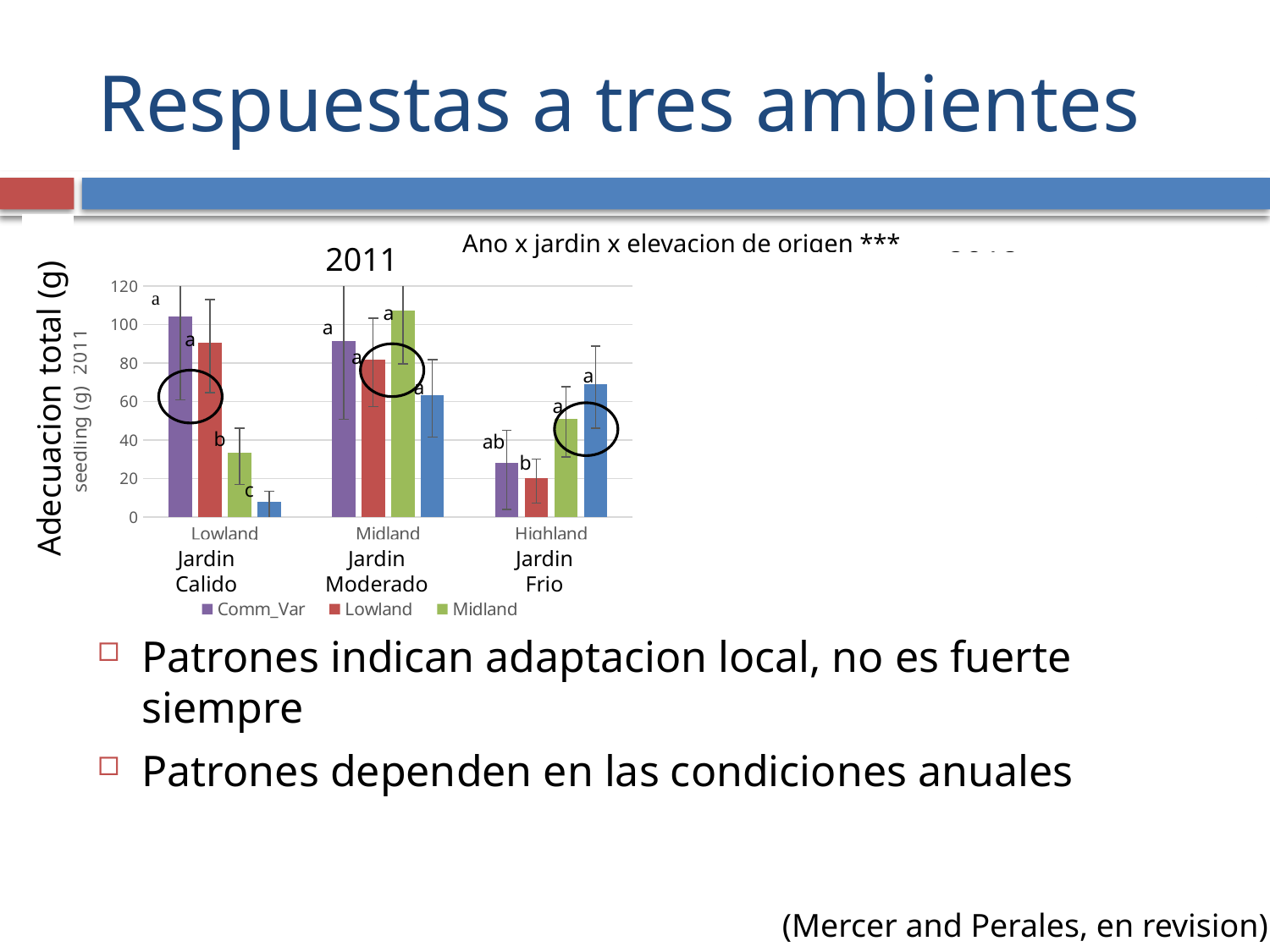
Which series has the highest bar in the Midland category? Midland What is the highest tick value shown on the y axis of the chart? 120 Is the value for the Midland series in the Midland category greater or less than 80? greater Is the value for the Midland series in the Lowland category greater or less than 40? less Is the value for Comm_Var in the Lowland category greater or less than 80? greater What is the title shown above the chart? 2011 How many bars are plotted in each category group of the chart? 4 Which is larger: the Comm_Var value in the Lowland category or the Comm_Var value in the Highland category? Lowland What kind of chart is shown on the slide? bar chart Do the Comm_Var values rise or fall from Lowland to Highland along the x axis? fall How many categories are shown on the x axis of the chart? 3